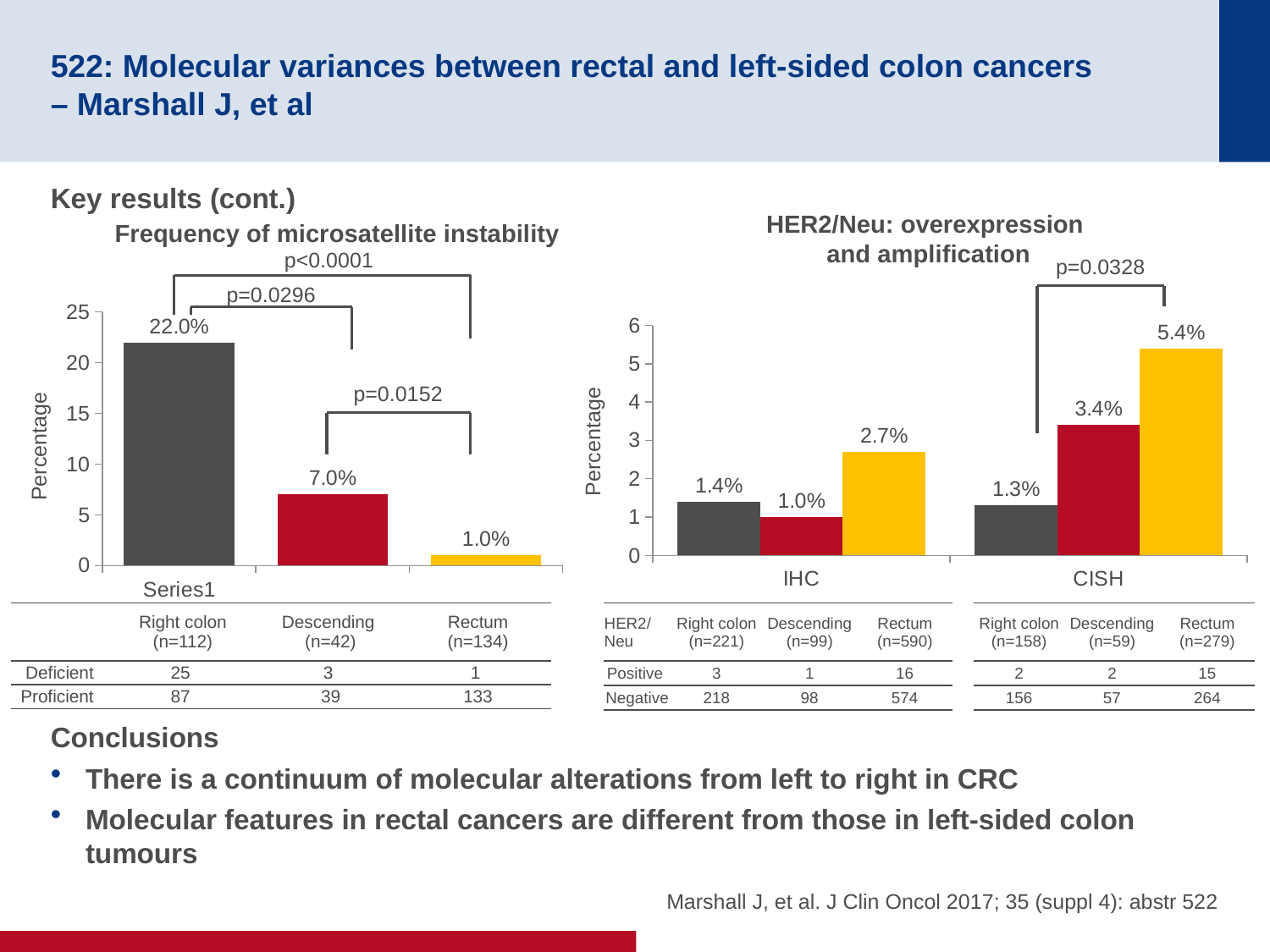
In the 'HER2/Neu: overexpression and amplification' chart, what is the value for Descending in the CISH group? 3.4% In the 'Frequency of microsatellite instability' chart, what is the value for Right colon? 22.0% In the 'HER2/Neu: overexpression and amplification' chart, what is the value for Rectum in the IHC group? 2.7% In the 'Frequency of microsatellite instability' chart, how many bars are plotted? 3 In the 'HER2/Neu: overexpression and amplification' chart, which bar has the lowest value? Descending (IHC), 1.0% In the 'Frequency of microsatellite instability' chart, what is the value for Rectum? 1.0% In the 'HER2/Neu: overexpression and amplification' chart, which is larger: Rectum in CISH or Rectum in IHC? Rectum in CISH In the 'HER2/Neu: overexpression and amplification' chart, what p-value is shown above the CISH group? p=0.0328 What type of chart is the 'HER2/Neu: overexpression and amplification' chart? Bar chart In the 'HER2/Neu: overexpression and amplification' chart, what is the difference between the Rectum and Right colon values in the CISH group? 4.1% In the 'Frequency of microsatellite instability' chart, which site has the highest value? Right colon In the 'Frequency of microsatellite instability' chart, what is the difference between the Right colon and Descending values? 15.0%